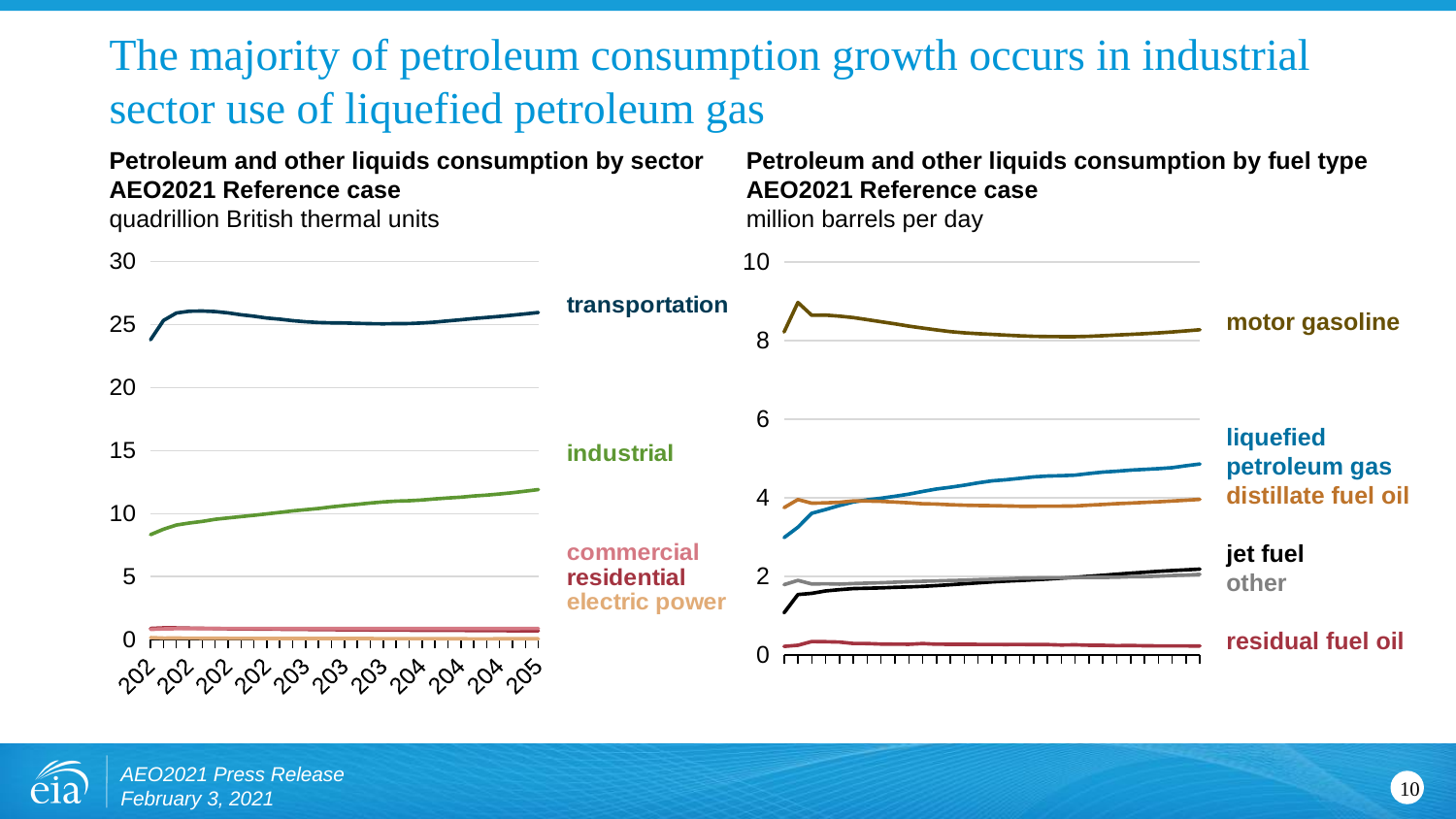
In the left chart (consumption by sector), which sector has the highest consumption? transportation In the left chart (consumption by sector), does the industrial line rise or fall over the period shown? rise In the right chart (consumption by fuel type), which fuel type has the highest consumption? motor gasoline In the right chart (consumption by fuel type), is the value for motor gasoline greater or less than 6? greater In the right chart (consumption by fuel type), does the liquefied petroleum gas line rise or fall over the period shown? rise In the left chart (consumption by sector), is the value for transportation greater or less than 20? greater What unit is used on the right chart (consumption by fuel type)? million barrels per day In the left chart (consumption by sector), how many series are labelled? 5 In the right chart (consumption by fuel type), which fuel type has the lowest consumption? residual fuel oil In the left chart (consumption by sector), is the value for industrial greater or less than 15? less In the right chart (consumption by fuel type), how many series are labelled? 6 What kind of chart is the 'Petroleum and other liquids consumption by sector' chart on the left? line chart